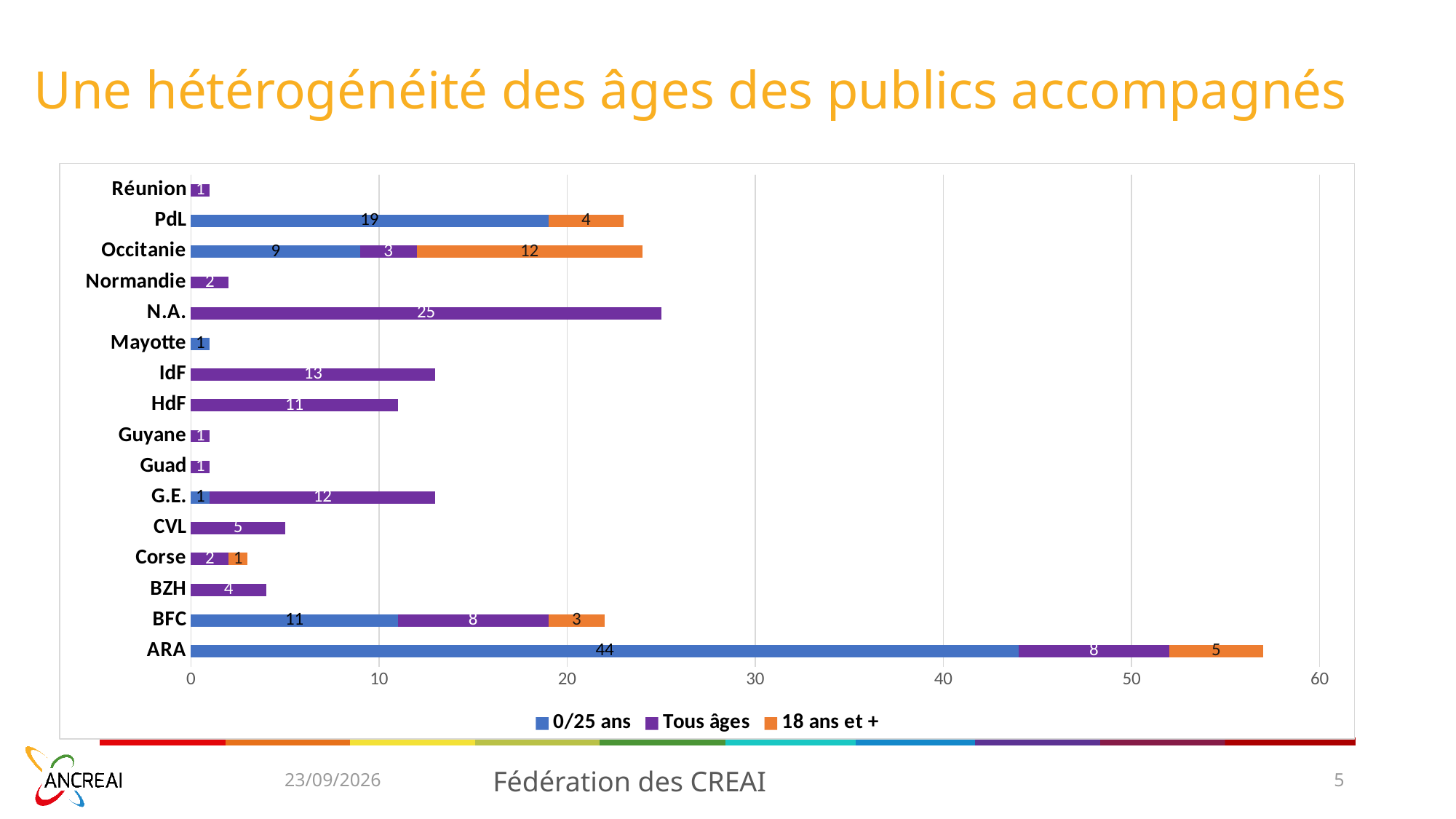
Which series is shown in orange in the legend? 18 ans et + Which is larger: the 'Tous âges' value for IdF or the 'Tous âges' value for HdF? IdF What is the value of the 'Tous âges' series for N.A.? 25 What type of chart is shown on the slide? Stacked bar chart How many series does the legend list? 3 What is the total of the stacked bar for ARA? 57 What is the total of the stacked bar for BFC? 22 What is the difference between the '0/25 ans' value for PdL and the '0/25 ans' value for Occitanie? 10 How many regions (categories) are shown on the chart? 16 What is the value of the '0/25 ans' series for ARA? 44 Which region has the longest stacked bar overall? ARA What is the value of the '18 ans et +' series for Occitanie? 12